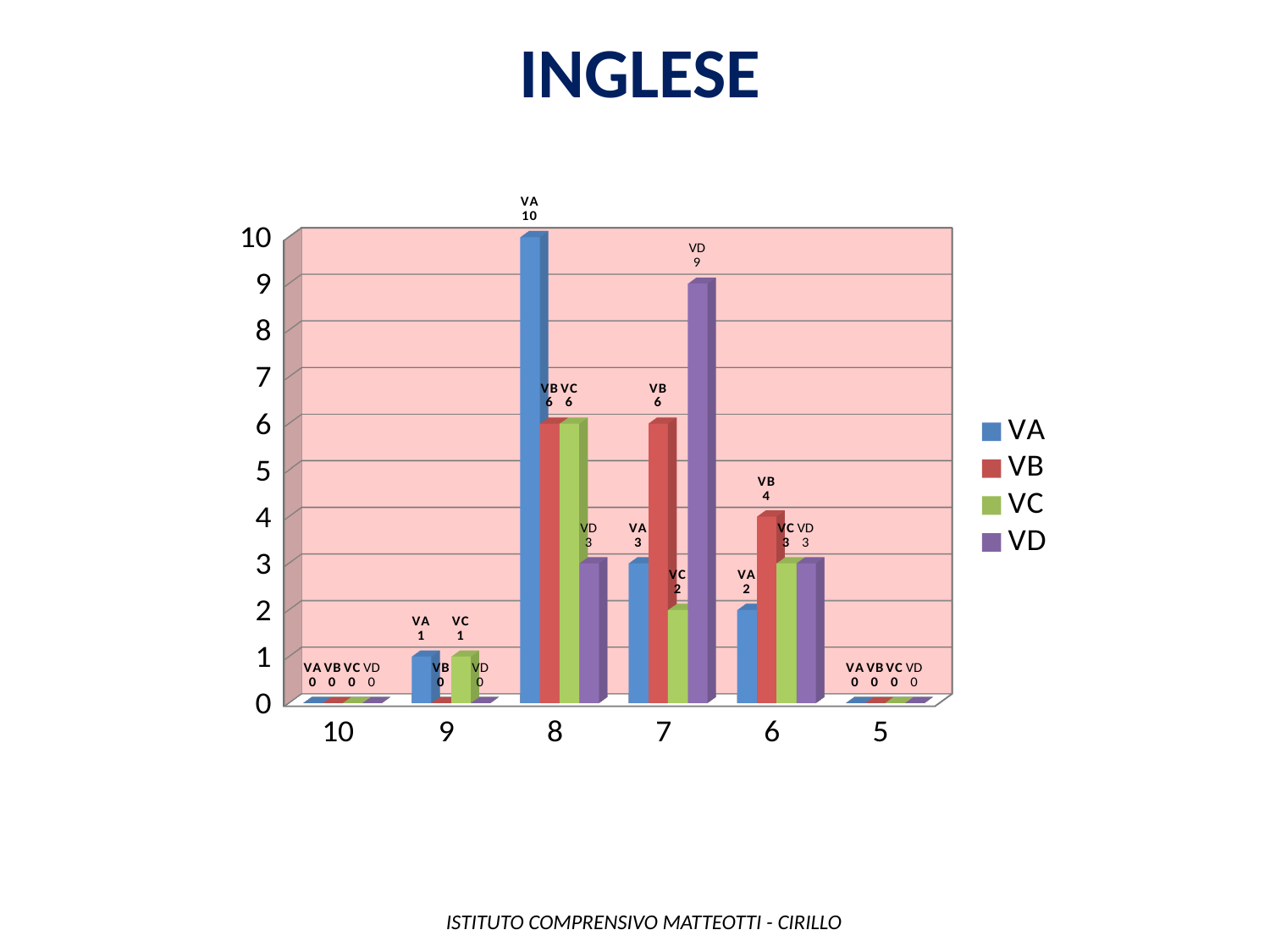
What is the title of the chart? INGLESE Which is larger at grade 6, VB or VA? VB What is the difference between VA and VB at grade 8? 4 What is the value for VA at grade 8? 10 What kind of chart is shown? bar chart What is the value for VD at grade 7? 9 How many grade categories are shown on the x axis? 6 Which series has the highest value at grade 7? VD What is the value for VC at grade 9? 1 How many series does the legend list? 4 Which series has the lowest value at grade 8? VD What is the value for VB at grade 6? 4